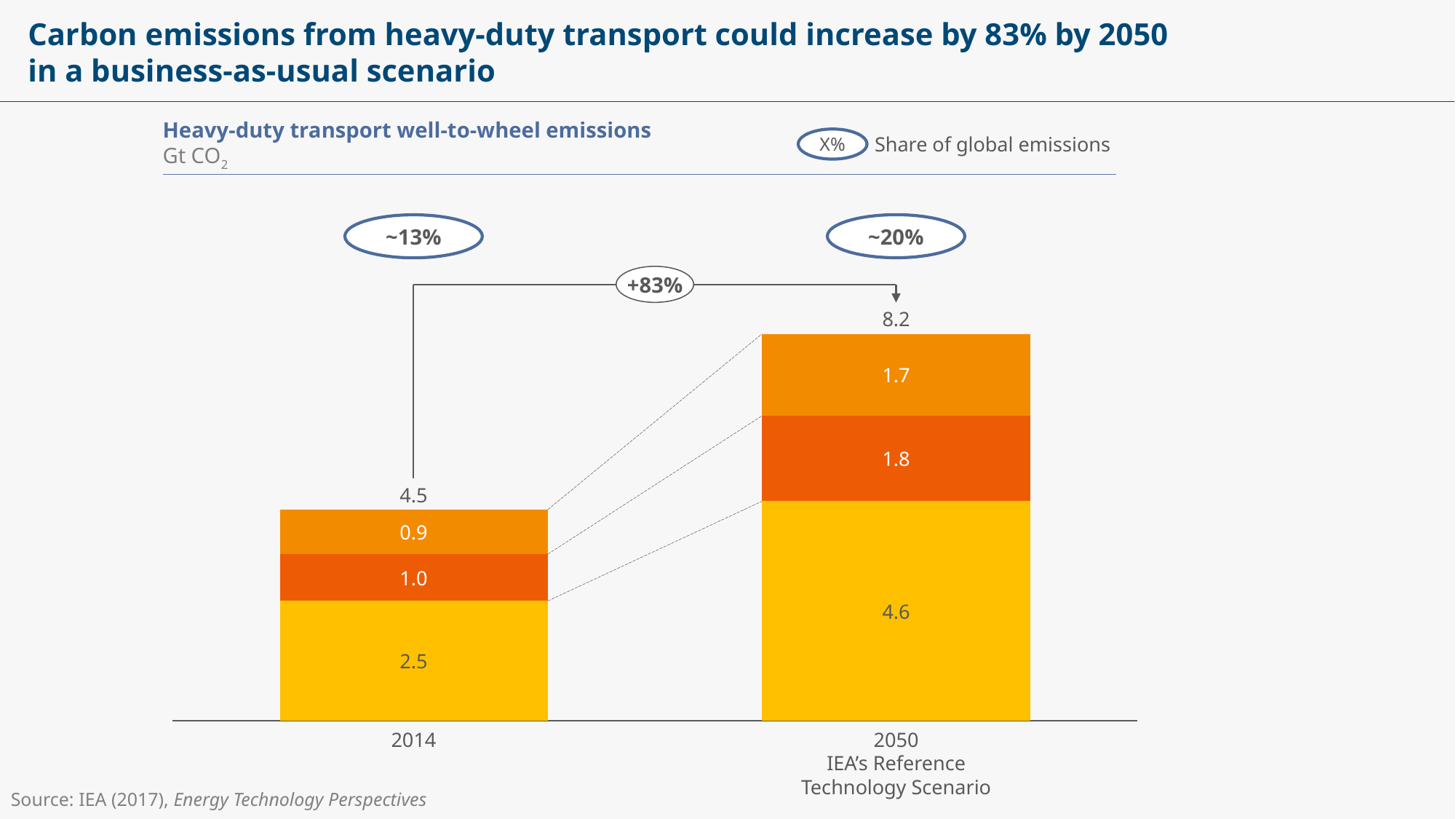
What is the value of the bottom (yellow) segment of the 2050 bar? 4.6 What percentage increase in emissions between 2014 and 2050 is labelled on the chart? +83% What is the value of the top (orange) segment of the 2014 bar? 0.9 How many bars (years) are shown in the chart? 2 Which year has the higher total emissions, 2014 or 2050? 2050 What is the value of the middle (dark orange) segment of the 2050 bar? 1.8 What is the value of the bottom (yellow) segment of the 2014 bar? 2.5 What share of global emissions is shown for heavy-duty transport in 2050? ~20% What is the total heavy-duty transport well-to-wheel emissions value shown for 2014? 4.5 What type of chart is shown on the slide? Stacked bar chart By how much does the total emissions value for 2050 exceed the total for 2014? 3.7 What is the total heavy-duty transport well-to-wheel emissions value shown for 2050? 8.2